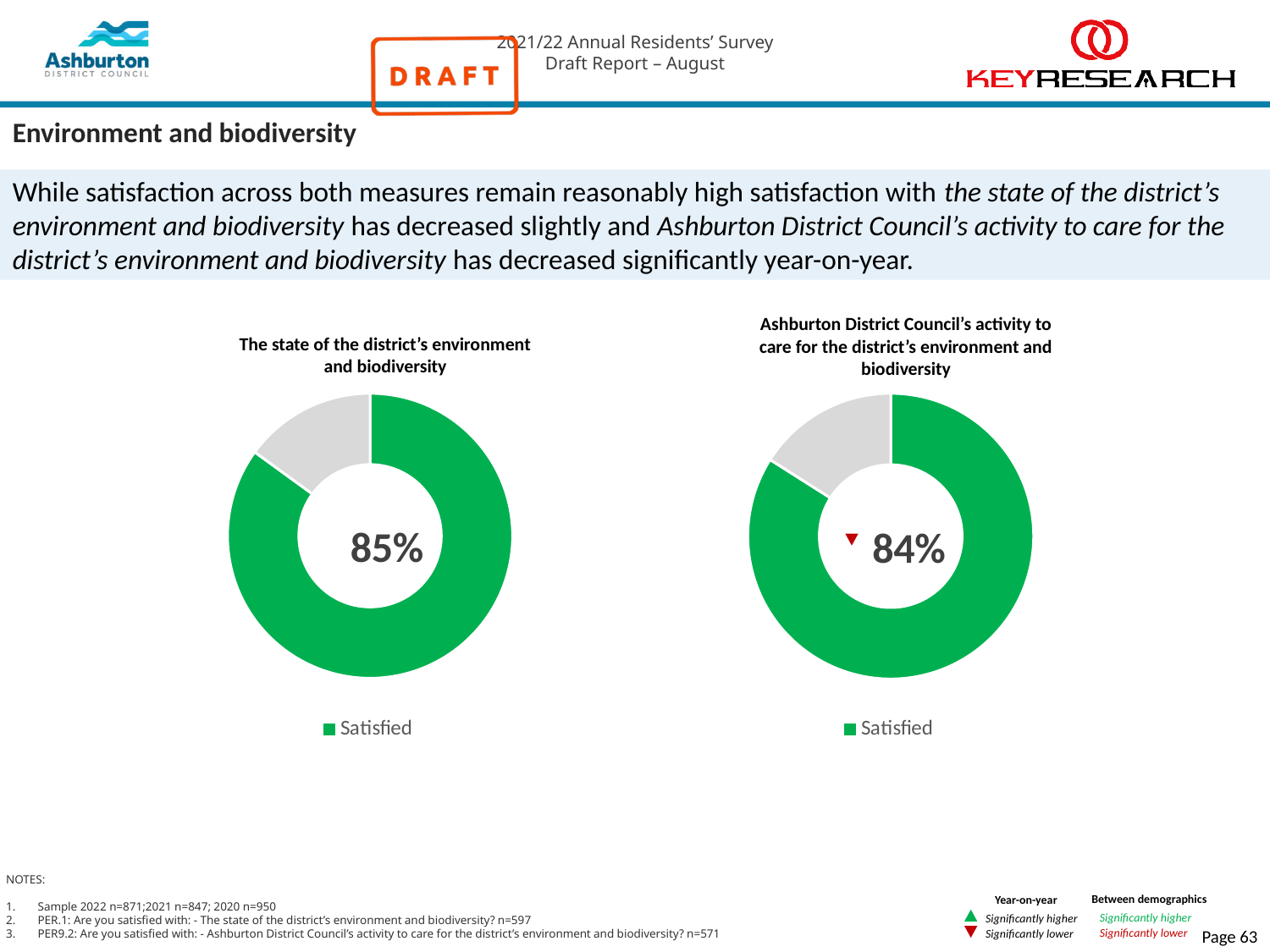
What colour represents the "Satisfied" slice in the left-hand chart? Green In the chart titled "Ashburton District Council's activity to care for the district's environment and biodiversity", what percentage of respondents are satisfied? 84% In the right-hand chart, is the satisfied value greater or less than 50%? greater In the chart titled "The state of the district's environment and biodiversity", what percentage of respondents are satisfied? 85% What is the legend entry shown under the chart titled "Ashburton District Council's activity to care for the district's environment and biodiversity"? Satisfied What is the difference in satisfied percentage between the left chart (85%) and the right chart (84%)? 1 percentage point What kind of chart is used for "The state of the district's environment and biodiversity"? Donut (pie) chart How many charts are shown on the slide? 2 How many series does the legend list for the chart titled "The state of the district's environment and biodiversity"? 1 Which chart shows the higher satisfied percentage, the left chart or the right chart? The left chart (The state of the district's environment and biodiversity) In the chart titled "The state of the district's environment and biodiversity", what share of the donut does the Satisfied slice represent? 85%